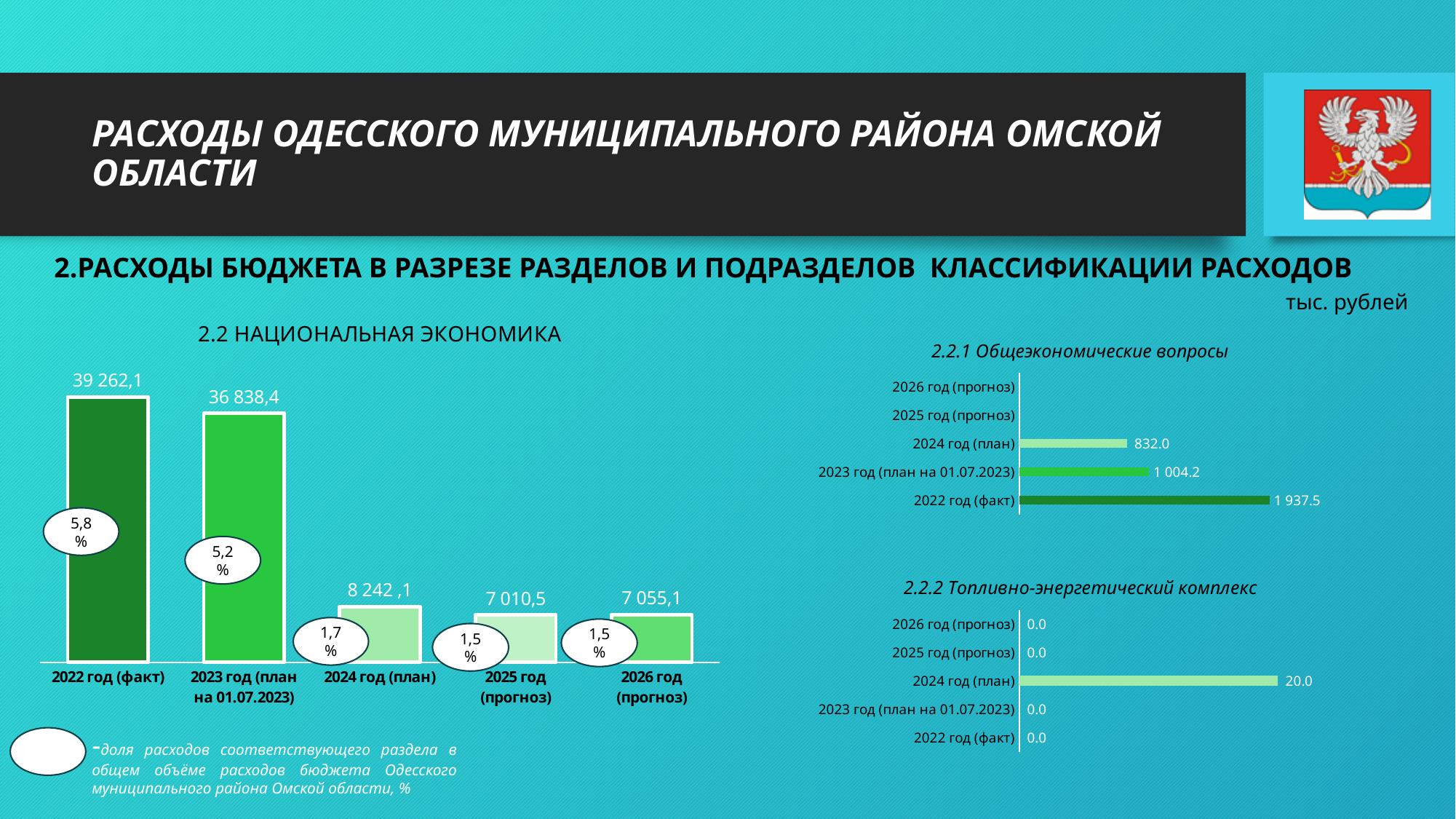
In the chart '2.2 НАЦИОНАЛЬНАЯ ЭКОНОМИКА', what is the difference between the values for 2022 год (факт) and 2023 год (план на 01.07.2023)? 2 423,7 In the chart '2.2 НАЦИОНАЛЬНАЯ ЭКОНОМИКА', what is the value for 2022 год (факт)? 39 262,1 In the chart '2.2 НАЦИОНАЛЬНАЯ ЭКОНОМИКА', how many bars are plotted? 5 In the chart '2.2.1 Общеэкономические вопросы', what is the difference between the values for 2022 год (факт) and 2024 год (план)? 1 105.5 In the chart '2.2.1 Общеэкономические вопросы', which category has the highest value? 2022 год (факт) In the chart '2.2 НАЦИОНАЛЬНАЯ ЭКОНОМИКА', what is the value for 2025 год (прогноз)? 7 010,5 In the chart '2.2 НАЦИОНАЛЬНАЯ ЭКОНОМИКА', which category has the highest value? 2022 год (факт) In the chart '2.2.2 Топливно-энергетический комплекс', what is the value for 2024 год (план)? 20.0 In the chart '2.2 НАЦИОНАЛЬНАЯ ЭКОНОМИКА', what share of total budget expenditure is shown in the oval for 2024 год (план)? 1,7 % In the chart '2.2.1 Общеэкономические вопросы', what is the value for 2023 год (план на 01.07.2023)? 1 004.2 What kind of chart is '2.2.2 Топливно-энергетический комплекс'? Bar chart In the chart '2.2 НАЦИОНАЛЬНАЯ ЭКОНОМИКА', which category has the lowest value? 2025 год (прогноз)